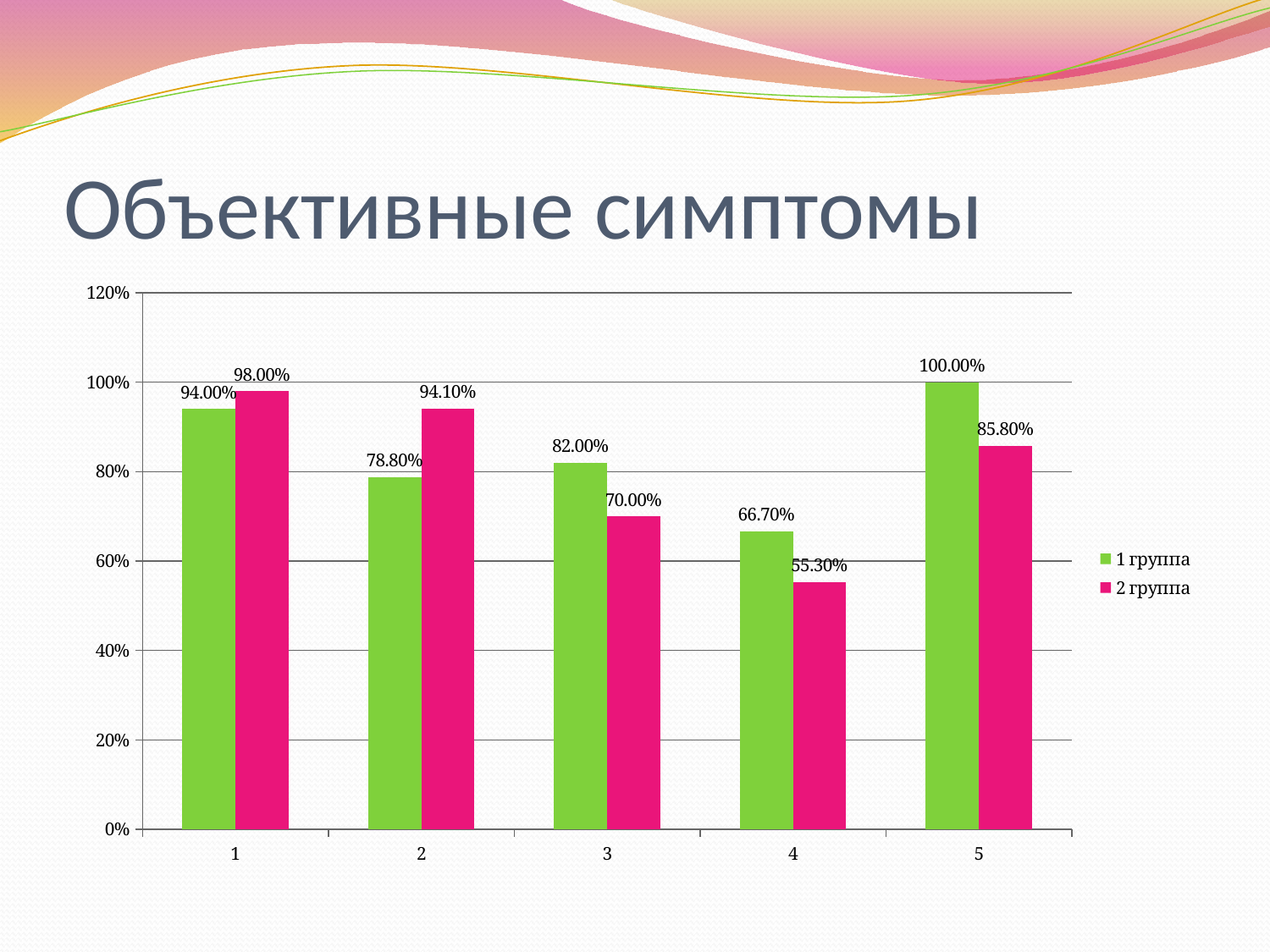
Is the value for 1 группа at category 4 greater or less than 60%? greater How many series does the legend list? 2 What is the value for 2 группа at category 2? 94.10% Which category has the highest value for 1 группа? 5 What is the value for 2 группа at category 4? 55.30% What is the title of the slide? Объективные симптомы Which category has the lowest value for 2 группа? 4 At category 2, which series has the larger value, 1 группа or 2 группа? 2 группа What is the value for 1 группа at category 1? 94.00% How many categories are shown on the x axis? 5 What is the difference between 1 группа and 2 группа at category 3? 12.00% What kind of chart is shown on the slide? bar chart